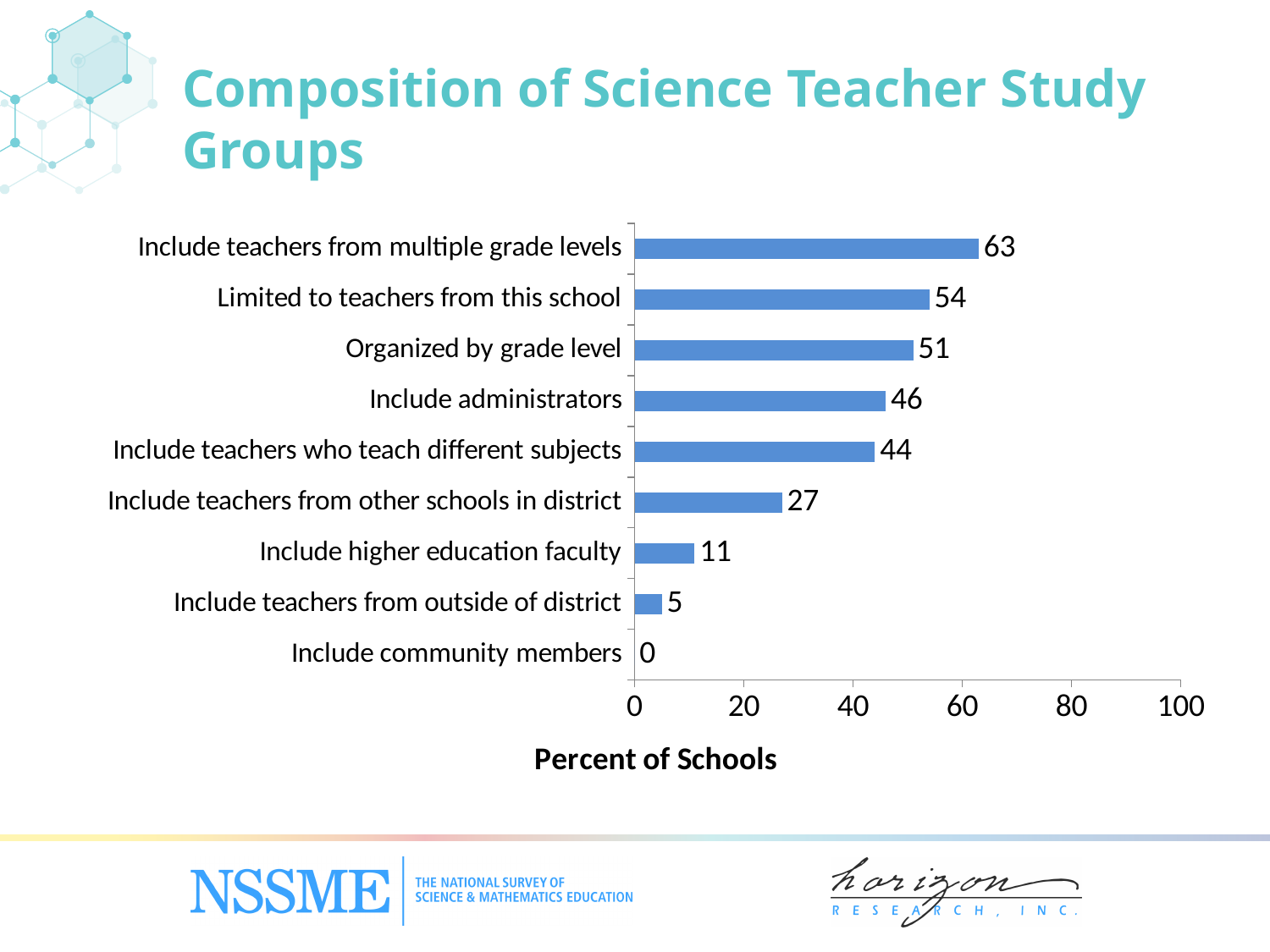
What is the value for 'Include teachers from other schools in district'? 27 What is the difference between 'Limited to teachers from this school' and 'Organized by grade level'? 3 What is the value for 'Include higher education faculty'? 11 What kind of chart is shown on the slide? bar chart How many categories are shown in the chart? 9 What is the difference between 'Include teachers from multiple grade levels' and 'Include teachers from outside of district'? 58 Which category has the lowest value? Include community members Which category has the highest value? Include teachers from multiple grade levels Which is larger: 'Include administrators' or 'Include teachers who teach different subjects'? Include administrators What percent of schools have science teacher study groups that include administrators? 46 Is the value for 'Include teachers from other schools in district' greater or less than 40? less What is the label of the horizontal axis? Percent of Schools